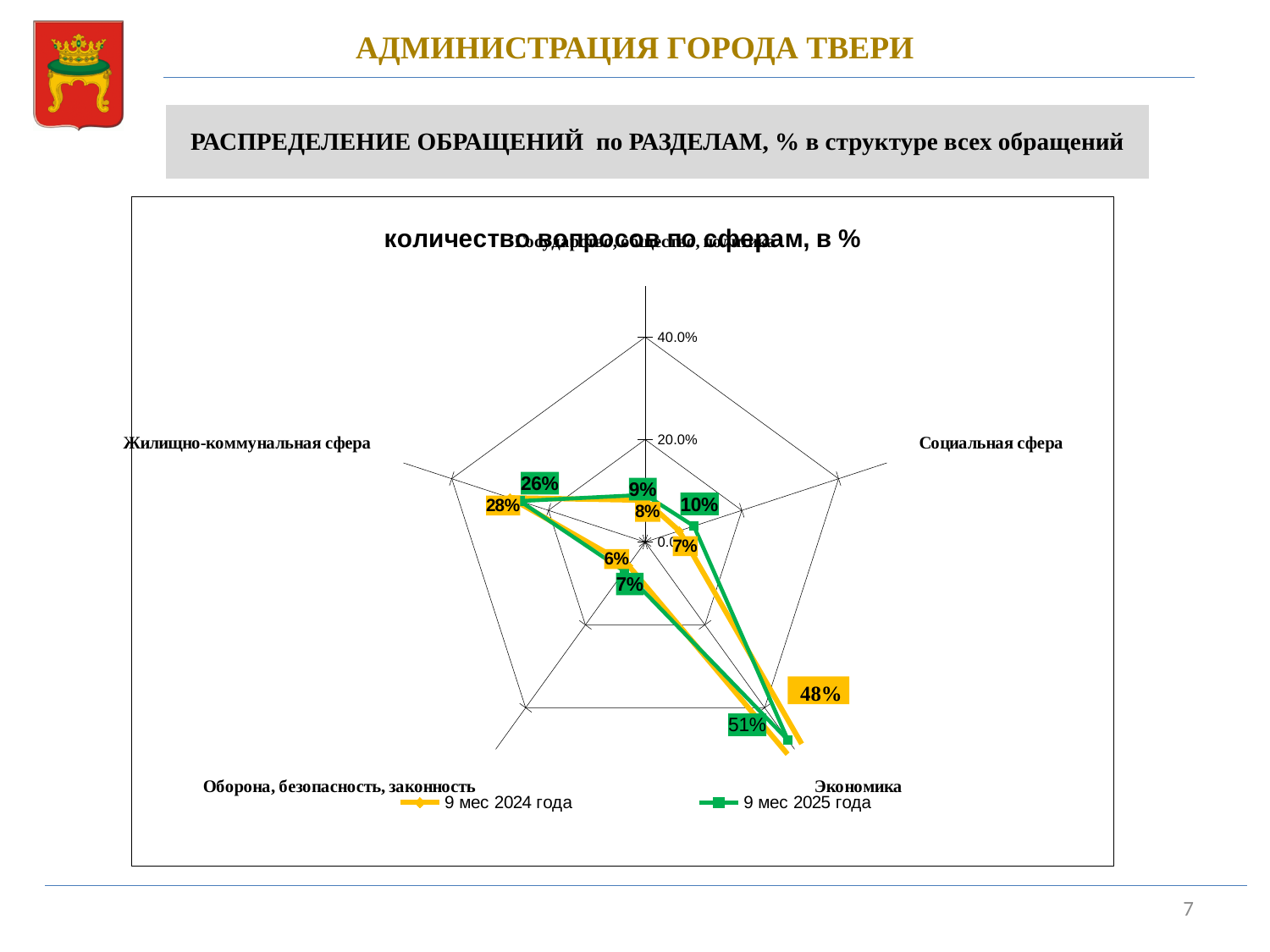
What is the value for Оборона, безопасность, законность in the 9 мес 2025 года series? 7% Which series is drawn in green? 9 мес 2025 года How many series does the legend list? 2 Which is larger for Жилищно-коммунальная сфера: the 9 мес 2024 года value or the 9 мес 2025 года value? 9 мес 2024 года What is the value for Жилищно-коммунальная сфера in the 9 мес 2024 года series? 28% Which category has the highest value in the 9 мес 2025 года series? Экономика Is the value for Экономика in the 9 мес 2025 года series greater or less than 40.0%? greater What kind of chart is shown on the slide? radar chart What is the difference between the 9 мес 2025 года and 9 мес 2024 года values for Экономика? 3% What is the value for Социальная сфера in the 9 мес 2025 года series? 10%